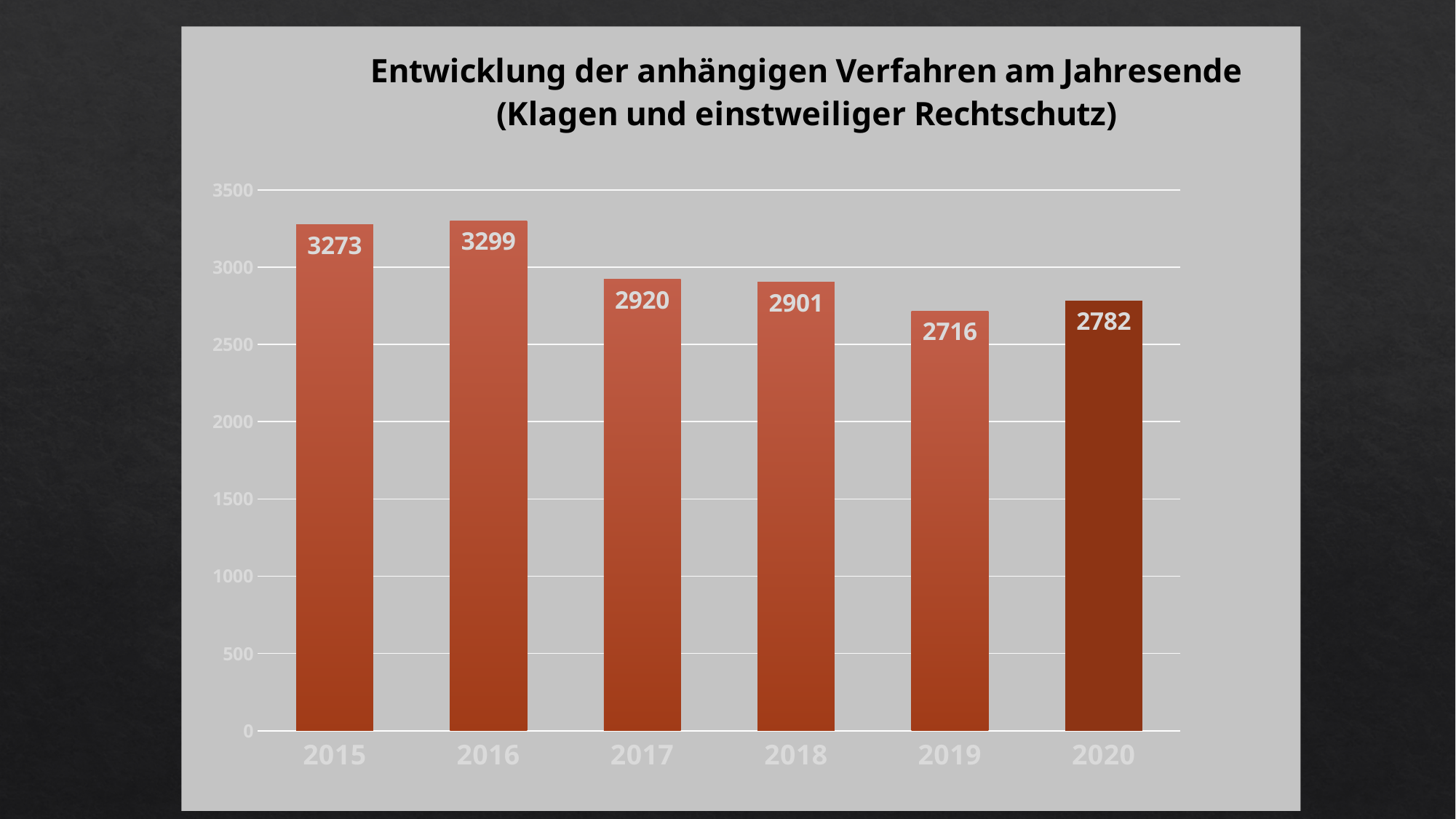
What is the value for 2015? 3273 What is the value for 2019? 2716 What is the difference between the values for 2019 and 2020? 66 What is the value for 2020? 2782 Which year has the highest value? 2016 Which year has the lowest value? 2019 How many years are shown on the x axis? 6 Which bar is shown in a darker colour than the others? 2020 What kind of chart is shown on the slide? bar chart Is the value for 2018 greater or less than 3000? less What is the difference between the values for 2016 and 2019? 583 Which is larger, the value for 2017 or the value for 2020? 2017